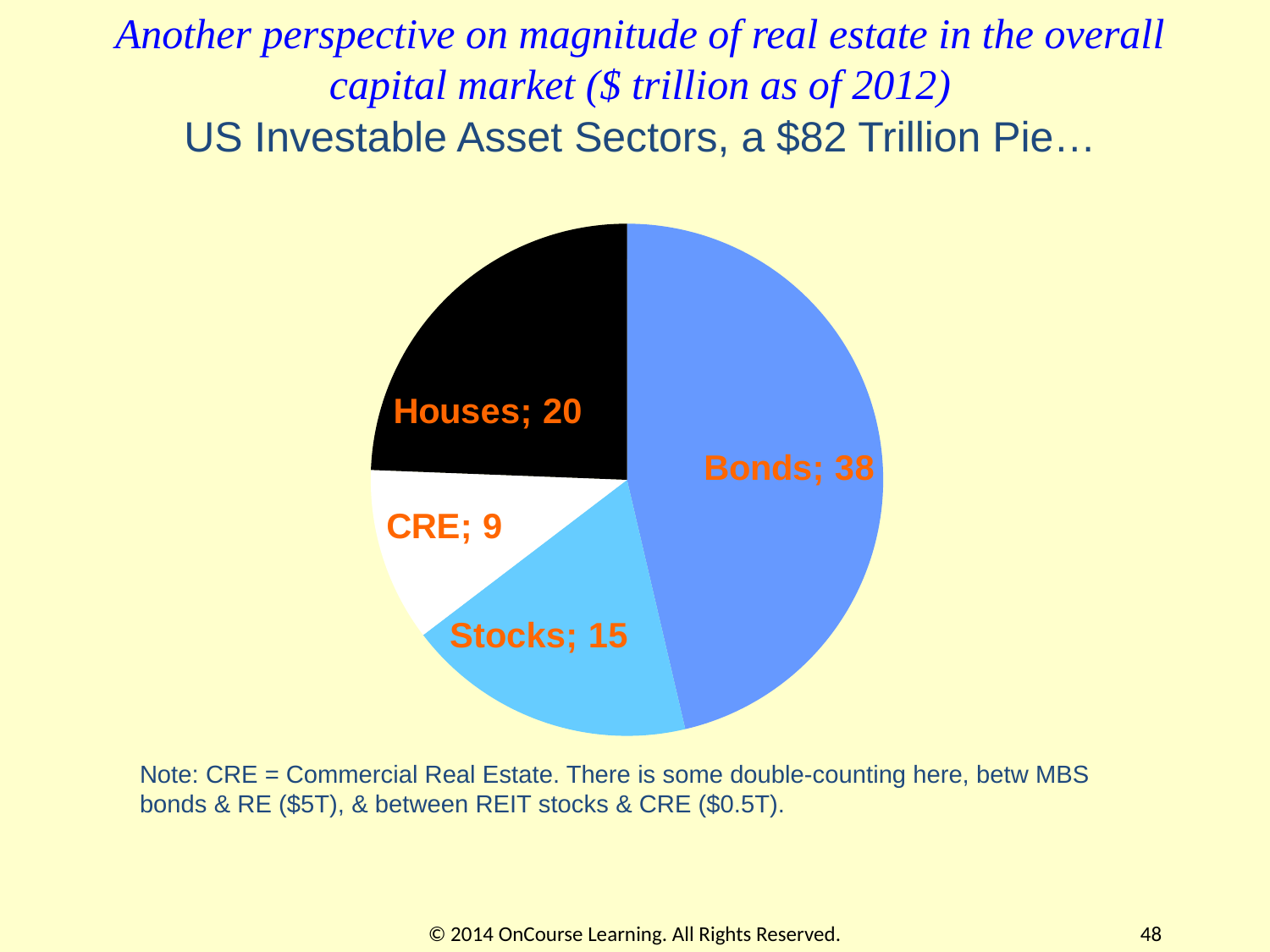
What is the difference between the values for Bonds and Houses? 18 Which is larger, the value for Houses or the value for Stocks? Houses How many sectors (slices) are shown in the pie chart? 4 What does CRE stand for, according to the note on the slide? Commercial Real Estate What type of chart is shown on the slide? pie chart What is the difference between the values for Stocks and CRE? 6 What is the value for CRE in the pie chart? 9 What is the value for Houses in the pie chart? 20 What is the value for Stocks in the pie chart? 15 What is the value for Bonds in the pie chart? 38 Which sector has the smallest slice of the pie? CRE Which sector has the largest slice of the pie? Bonds